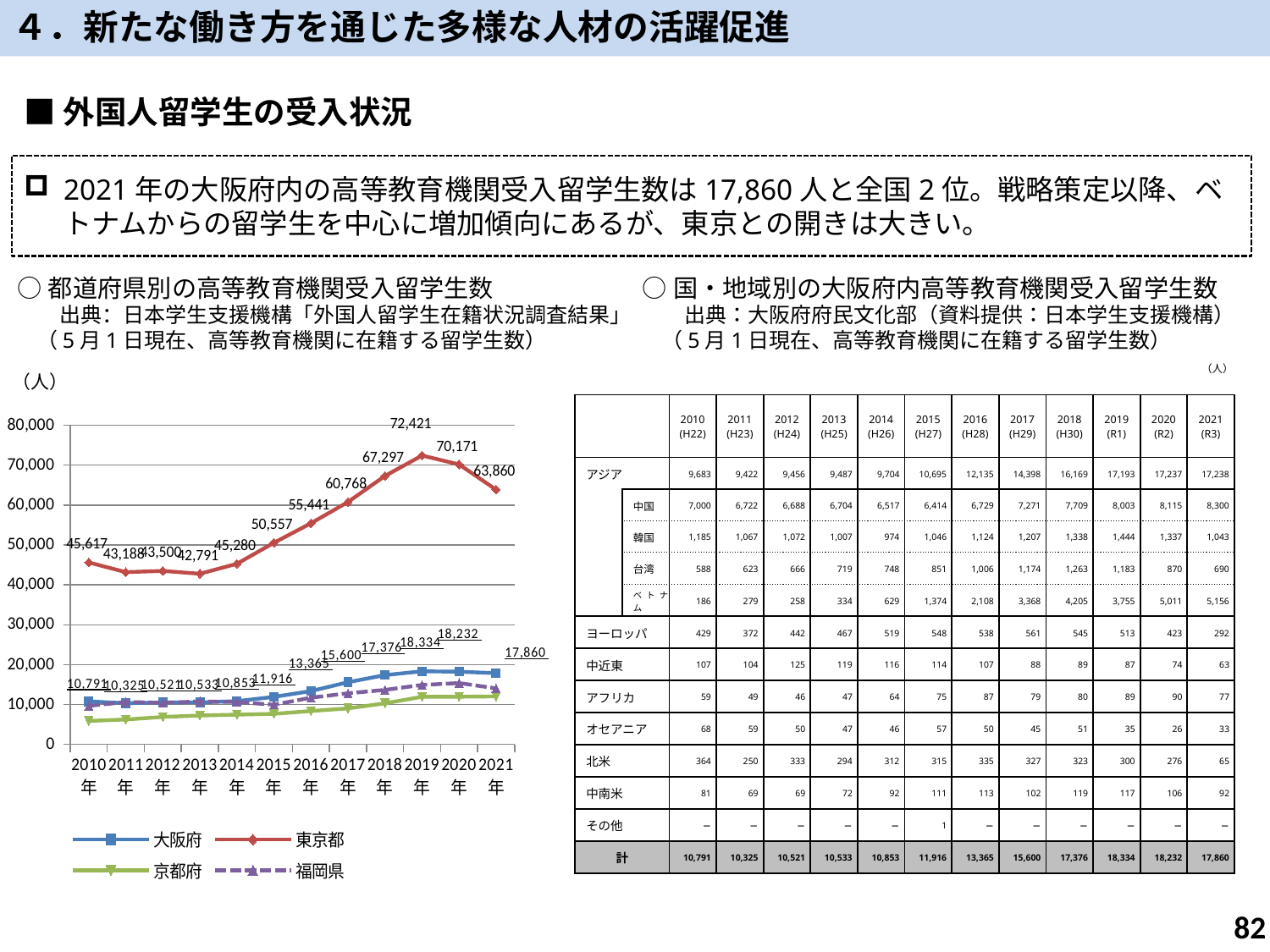
In the line chart, what is the difference between the 東京都 value and the 大阪府 value in 2021年? 46,000 In the line chart, does the value for 大阪府 rise or fall from 2015年 to 2019年? rise In the line chart, in which year does 東京都 reach its highest value? 2019年 In the line chart, what is the value for 東京都 in 2019年? 72,421 In the line chart, which series has the larger value in 2018年, 東京都 or 大阪府? 東京都 In the line chart, what is the value for 大阪府 in 2021年? 17,860 How many series does the legend of the line chart list? 4 In the line chart, in which year is the value for 東京都 lowest? 2013年 In the line chart, is the value for 京都府 in 2021年 greater or less than 20,000? less In the line chart, what is the value for 大阪府 in 2010年? 10,791 What kind of chart is shown on the left of the slide? Line chart How many years are plotted along the x axis of the line chart? 12